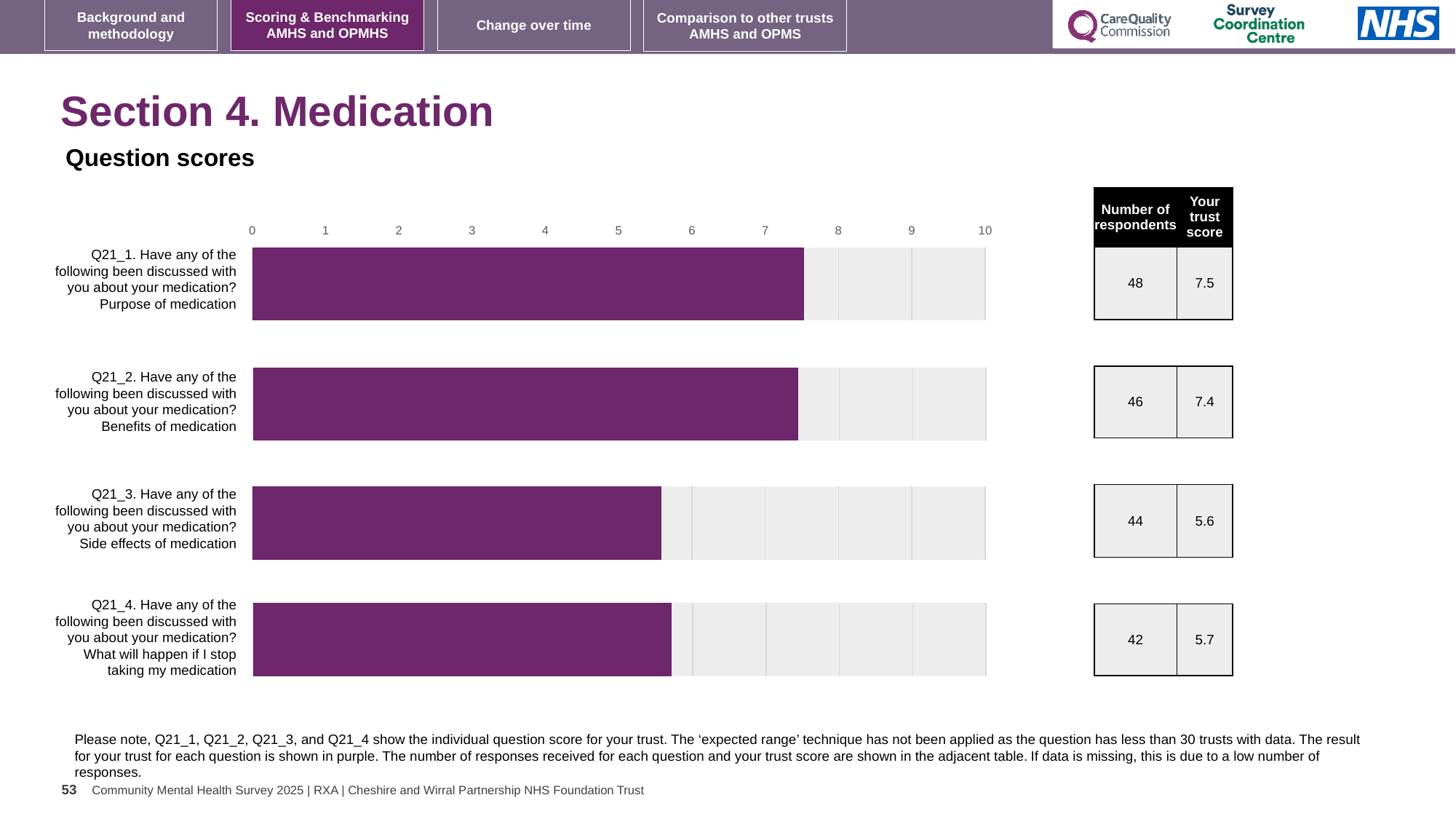
What is the maximum value shown on the chart's axis? 10 What is the trust score for Q21_1 (Purpose of medication)? 7.5 What kind of chart is shown on the slide? Bar chart Which question has the highest trust score? Q21_1. Purpose of medication Which question has the lowest trust score? Q21_3. Side effects of medication What is the difference between the trust scores for Q21_1 (Purpose of medication) and Q21_3 (Side effects of medication)? 1.9 Is the trust score for Q21_2 (Benefits of medication) greater or less than 7? greater How many respondents answered Q21_4 (What will happen if I stop taking my medication)? 42 How many questions are plotted in the chart? 4 Is the trust score for Q21_4 (What will happen if I stop taking my medication) greater or less than 6? less Which has the larger trust score, Q21_2 (Benefits of medication) or Q21_4 (What will happen if I stop taking my medication)? Q21_2. Benefits of medication What is the trust score for Q21_3 (Side effects of medication)? 5.6